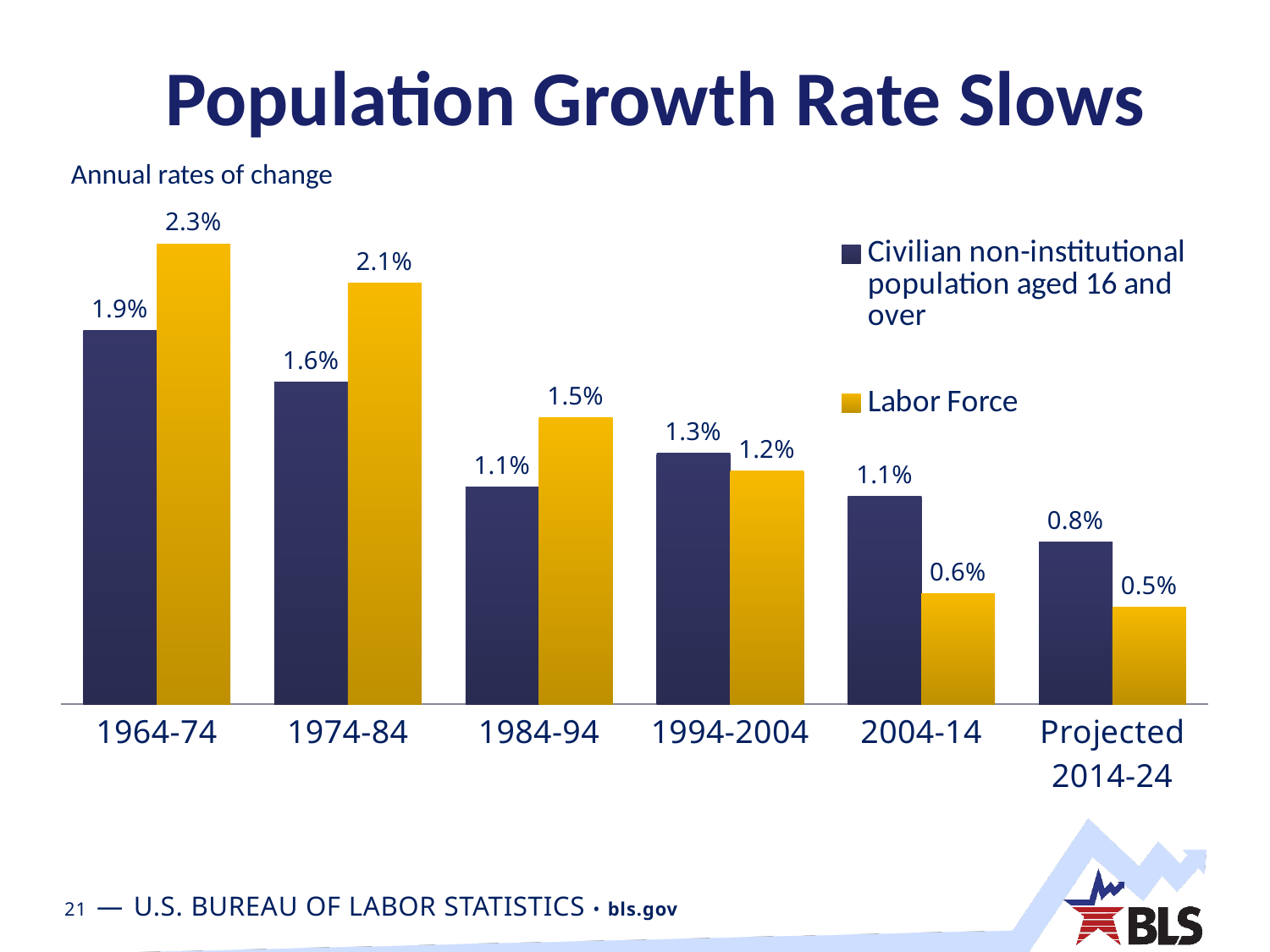
What is the Civilian non-institutional population aged 16 and over rate for 2004-14? 1.1% How many time periods are shown on the x axis? 6 Which period has the lowest Civilian non-institutional population aged 16 and over rate? Projected 2014-24 Which period has the highest Labor Force rate? 1964-74 What is the Labor Force annual rate of change for 1964-74? 2.3% In 2004-14, which is larger: the Civilian non-institutional population rate or the Labor Force rate? Civilian non-institutional population aged 16 and over What colour are the Labor Force bars? Yellow Do the Labor Force rates rise or fall across the periods from 1964-74 to Projected 2014-24? Fall How many series does the legend list? 2 What is the Labor Force rate for Projected 2014-24? 0.5% What kind of chart is shown on the slide? Bar chart What is the difference between the Labor Force rate and the Civilian non-institutional population rate in 1974-84? 0.5%